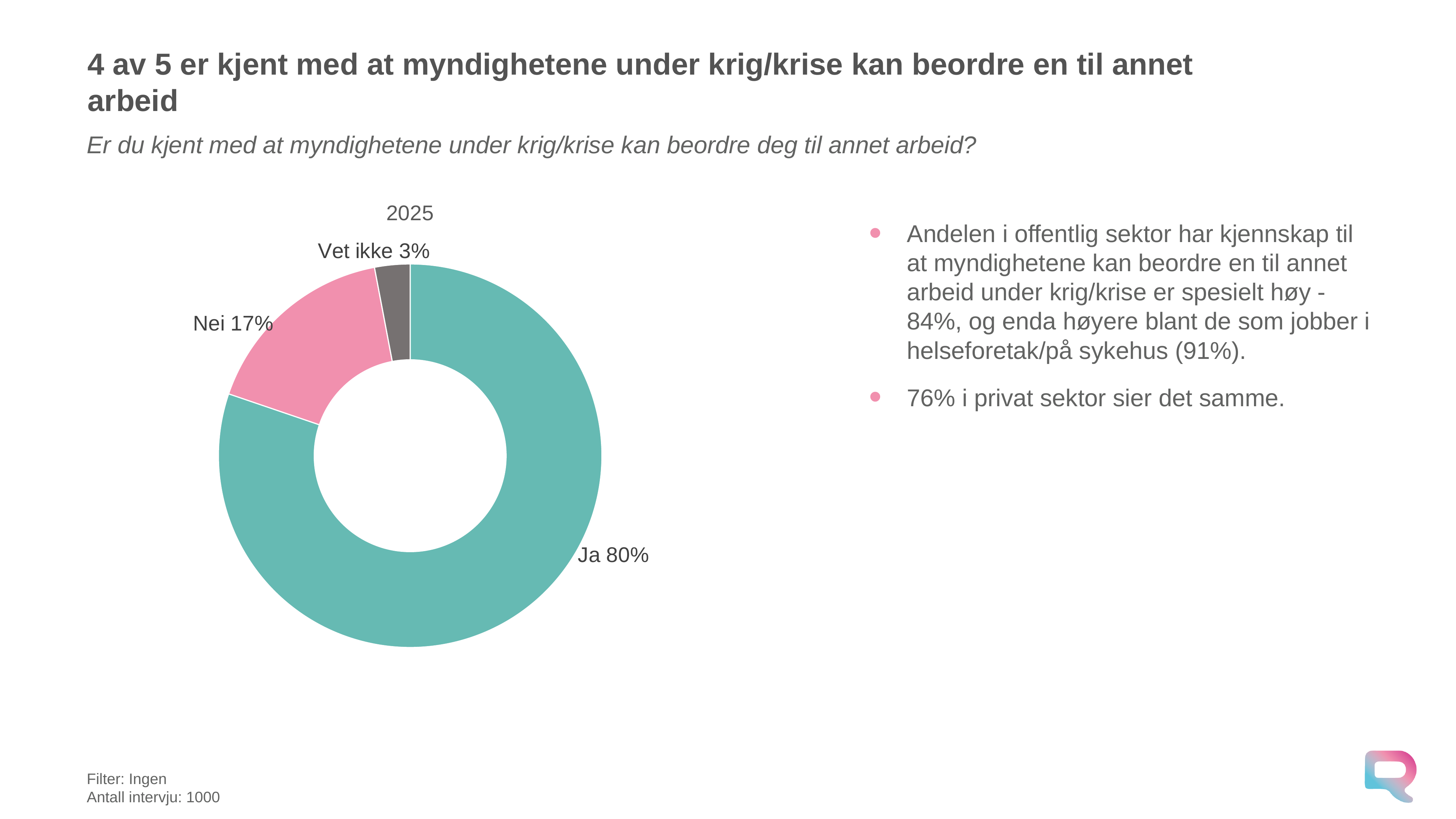
What is the title shown above the chart? 2025 What percentage of respondents answered "Ja" in the 2025 chart? 80% What percentage of respondents answered "Vet ikke"? 3% What is the difference in percentage points between "Ja" and "Nei"? 63 What is the difference in percentage points between "Nei" and "Vet ikke"? 14 Which is larger, the share for "Nei" or the share for "Vet ikke"? Nei Which response category has the smallest share of the chart? Vet ikke What kind of chart is shown on the slide? Pie chart (donut) How many response categories are shown in the chart? 3 What colour is the "Nei" slice? Pink Which response category has the largest share of the chart? Ja What percentage of respondents answered "Nei"? 17%